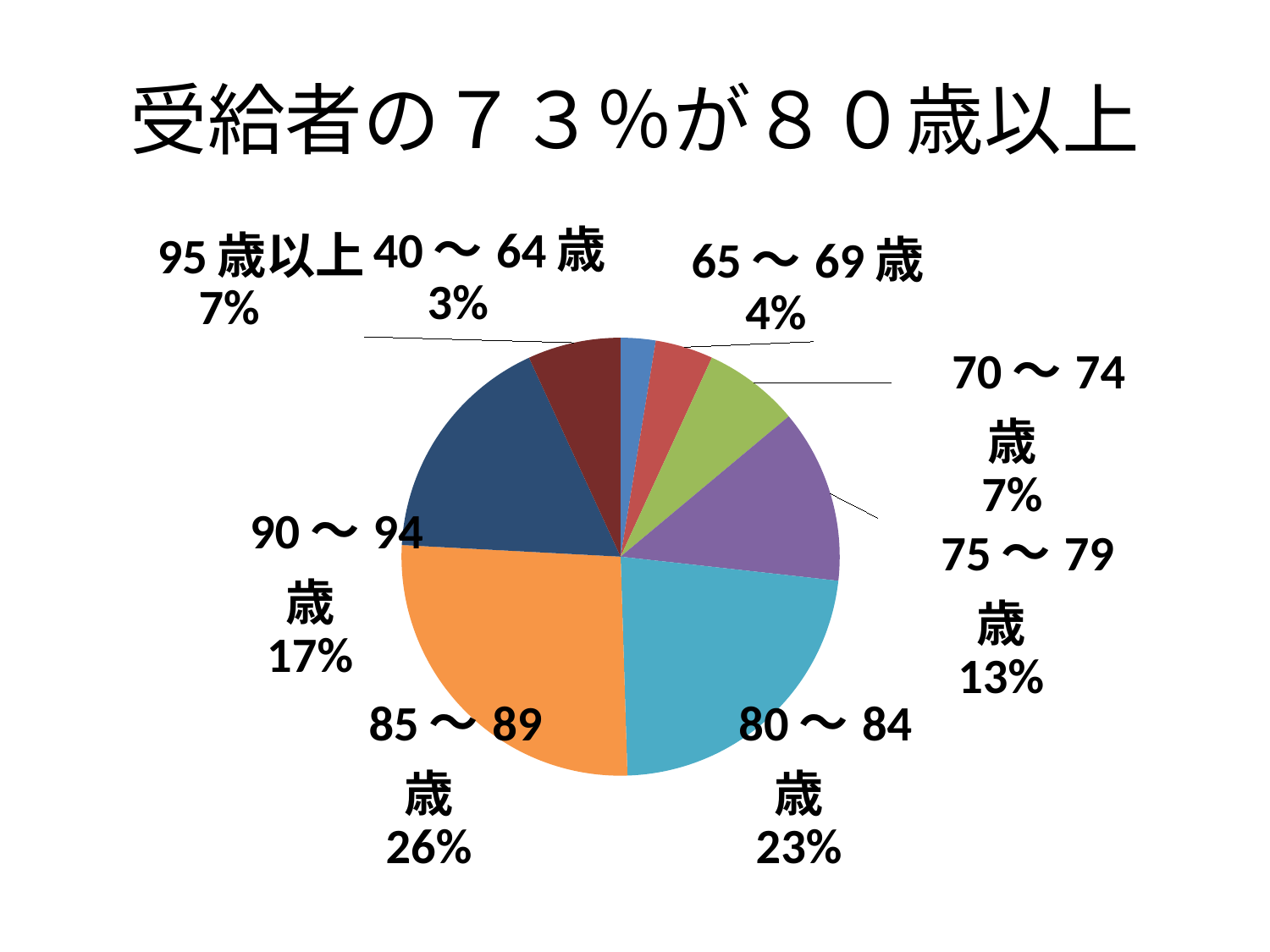
What share of the pie is the 80～84歳 slice? 23% What kind of chart is shown on the slide? pie chart What share of the pie is the 85～89歳 slice? 26% What is the combined share of the 80～84歳 and 85～89歳 slices? 49% What is the title of the slide? 受給者の７３％が８０歳以上 Which slice is larger, 65～69歳 or 70～74歳? 70～74歳 What share of the pie is the 40～64歳 slice? 3% Which age group has the largest slice of the pie? 85～89歳 How many slices does the pie chart have? 8 Which age group has the smallest slice of the pie? 40～64歳 What is the difference in percentage points between the 85～89歳 slice and the 90～94歳 slice? 9